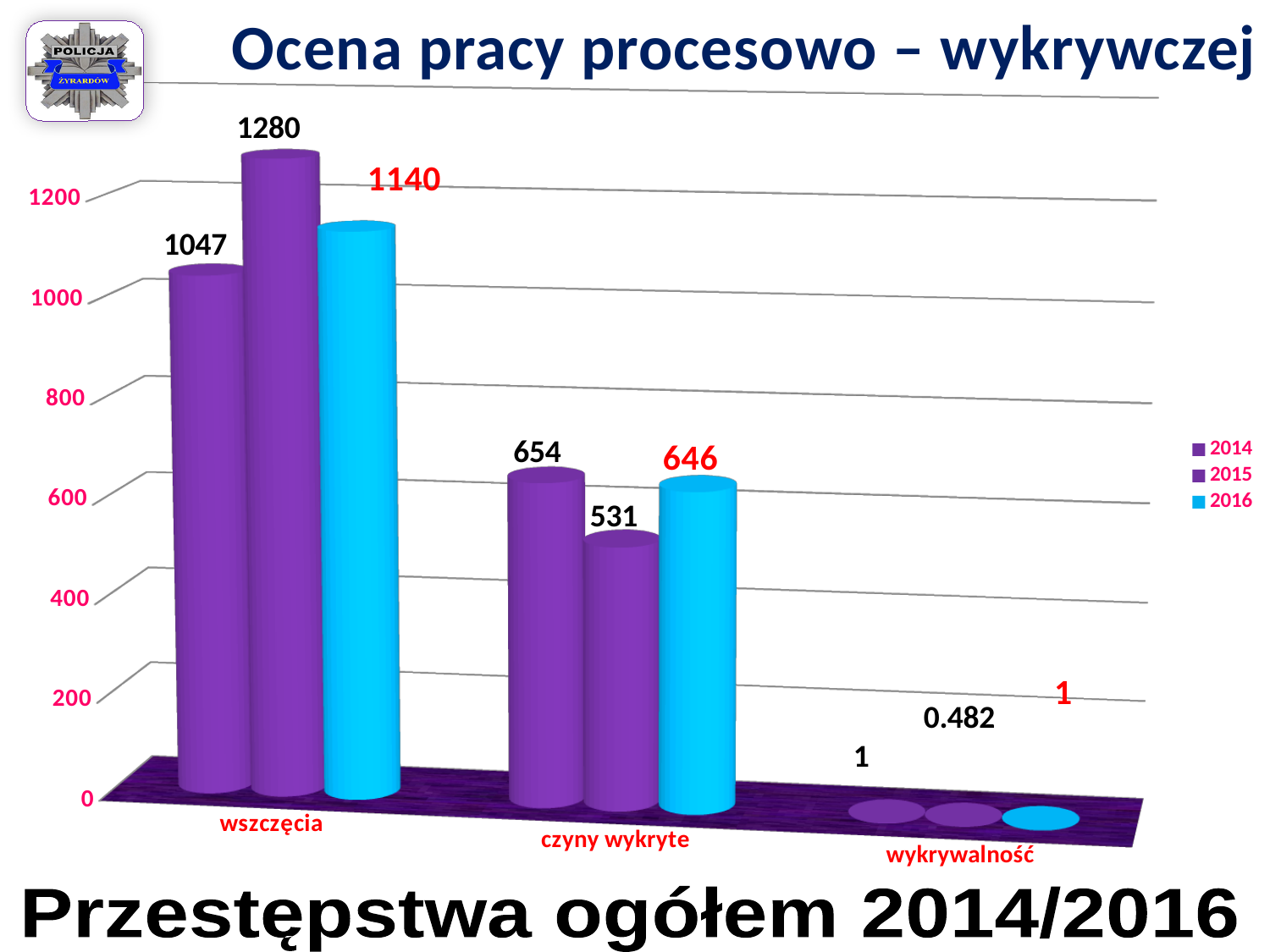
How many categories are shown on the x axis? 3 What kind of chart is shown on the slide? bar chart Which is larger in the czyny wykryte category, the 2014 value or the 2016 value? 2014 What is the value for 2014 in the wszczęcia category? 1047 Which year has the lowest value in the czyny wykryte category? 2015 What is the value for 2016 in the czyny wykryte category? 646 How many series does the legend list? 3 What is the difference between the 2015 and 2014 values in the wszczęcia category? 233 What is the value for 2015 in the wszczęcia category? 1280 What is the difference between the 2014 and 2015 values in the czyny wykryte category? 123 What is the value for 2015 in the wykrywalność category? 0.482 Which year has the highest value in the wszczęcia category? 2015